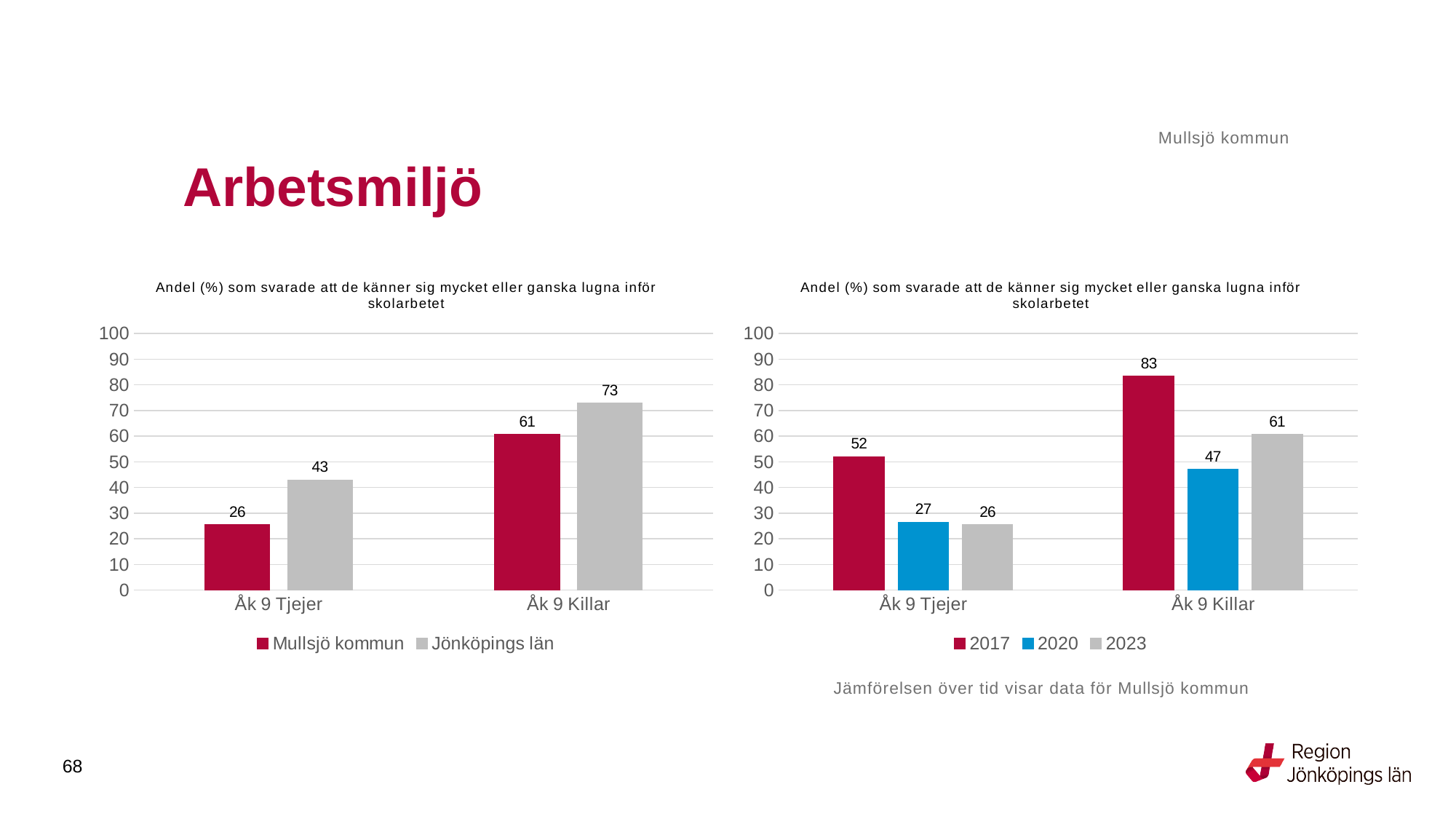
In the right chart, which year has the lowest value for Åk 9 Tjejer? 2023 In the right chart, what is the value for 2017 for Åk 9 Killar? 83 What kind of chart is the right chart? Bar chart In the left chart, what is the value for Jönköpings län for Åk 9 Killar? 73 In the left chart, what is the difference between Jönköpings län and Mullsjö kommun for Åk 9 Tjejer? 17 How many series does the legend of the right chart list? 3 In the right chart, what is the value for 2020 for Åk 9 Tjejer? 27 In the right chart, what is the difference between the 2017 and 2023 values for Åk 9 Killar? 22 How many series does the legend of the left chart list? 2 In the left chart, which is larger for Åk 9 Killar: Mullsjö kommun or Jönköpings län? Jönköpings län In the left chart, what is the value for Mullsjö kommun for Åk 9 Tjejer? 26 In the right chart, do the values for Åk 9 Tjejer rise or fall from 2017 to 2023? Fall